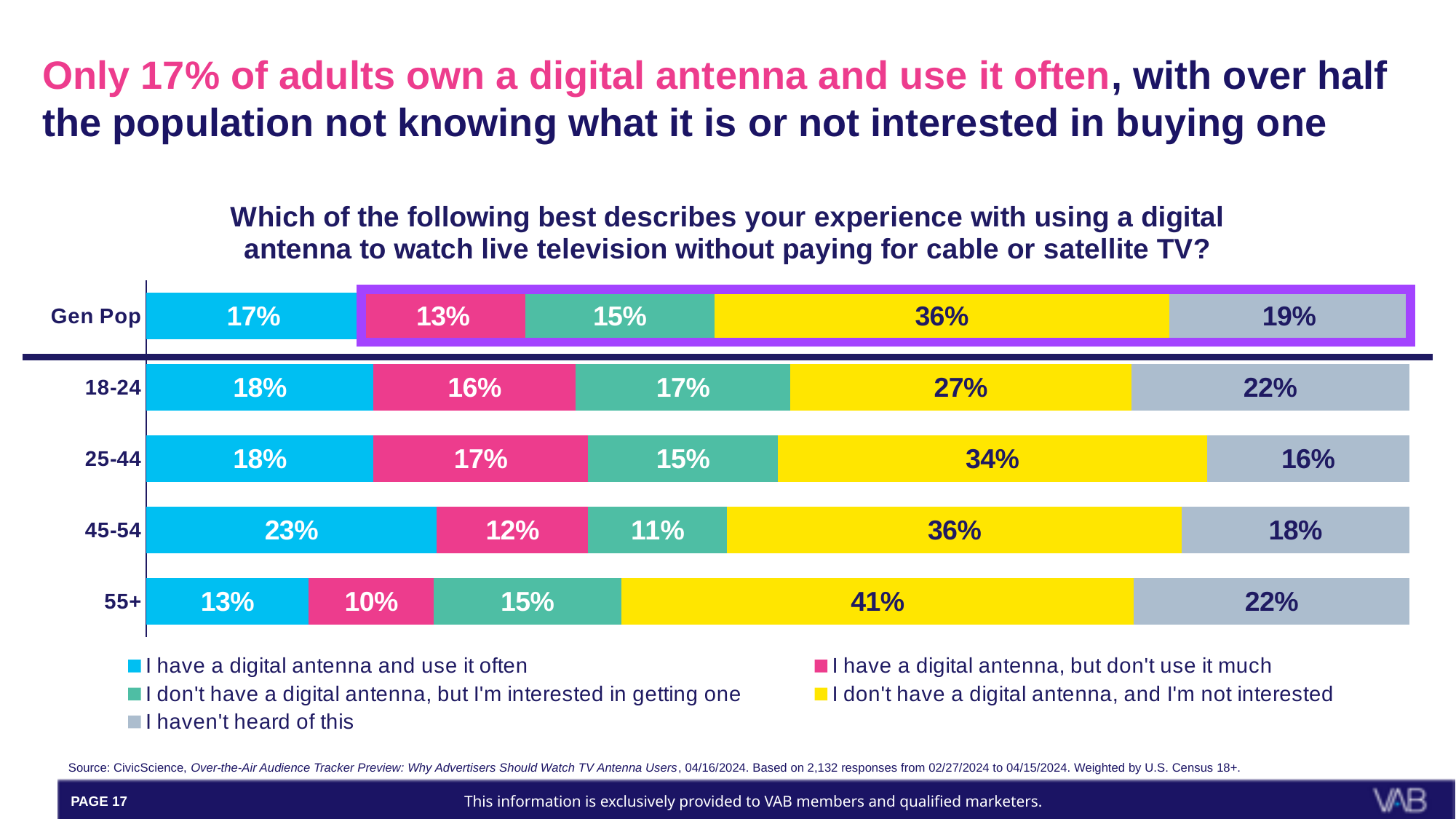
Which group has the lowest share for "I have a digital antenna and use it often"? 55+ How many series does the legend list? 5 Which group has the highest share for "I don't have a digital antenna, and I'm not interested"? 55+ How many percentage points higher is the "not interested" share for 55+ than for 18-24? 14 percentage points What percentage of the 45-54 group says "I have a digital antenna and use it often"? 23% How many groups (bars) are shown in the chart? 5 What percentage of the Gen Pop group says "I have a digital antenna and use it often"? 17% What percentage of the 55+ group says "I don't have a digital antenna, and I'm not interested"? 41% Which age group has the highest share for "I have a digital antenna and use it often"? 45-54 Which group has a larger share for "I haven't heard of this": 18-24 or 25-44? 18-24 What kind of chart is shown on the slide? Stacked bar chart What is the total of the Gen Pop stacked bar? 100%